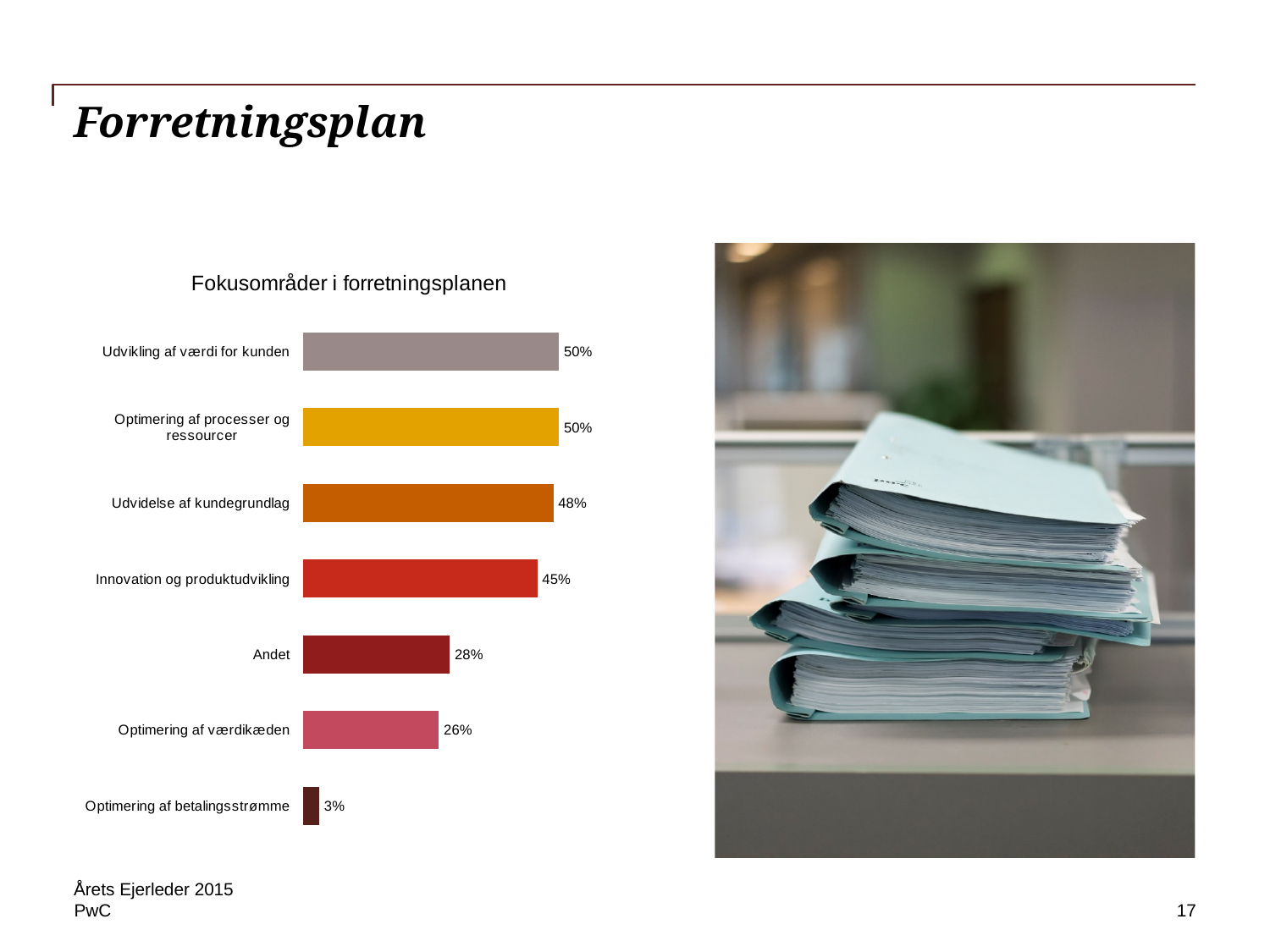
What is the value for Andet? 28% Which category has the lowest value? Optimering af betalingsstrømme What is the value for Udvikling af værdi for kunden? 50% What is the title of the chart? Fokusområder i forretningsplanen Which is larger, Udvidelse af kundegrundlag or Andet? Udvidelse af kundegrundlag How many categories are shown in the chart? 7 What is the value for Optimering af værdikæden? 26% Which is larger, Optimering af værdikæden or Optimering af betalingsstrømme? Optimering af værdikæden What is the difference between Udvidelse af kundegrundlag and Innovation og produktudvikling? 3% What is the value for Innovation og produktudvikling? 45% What is the difference between Andet and Optimering af værdikæden? 2% What kind of chart is shown on the slide? Bar chart